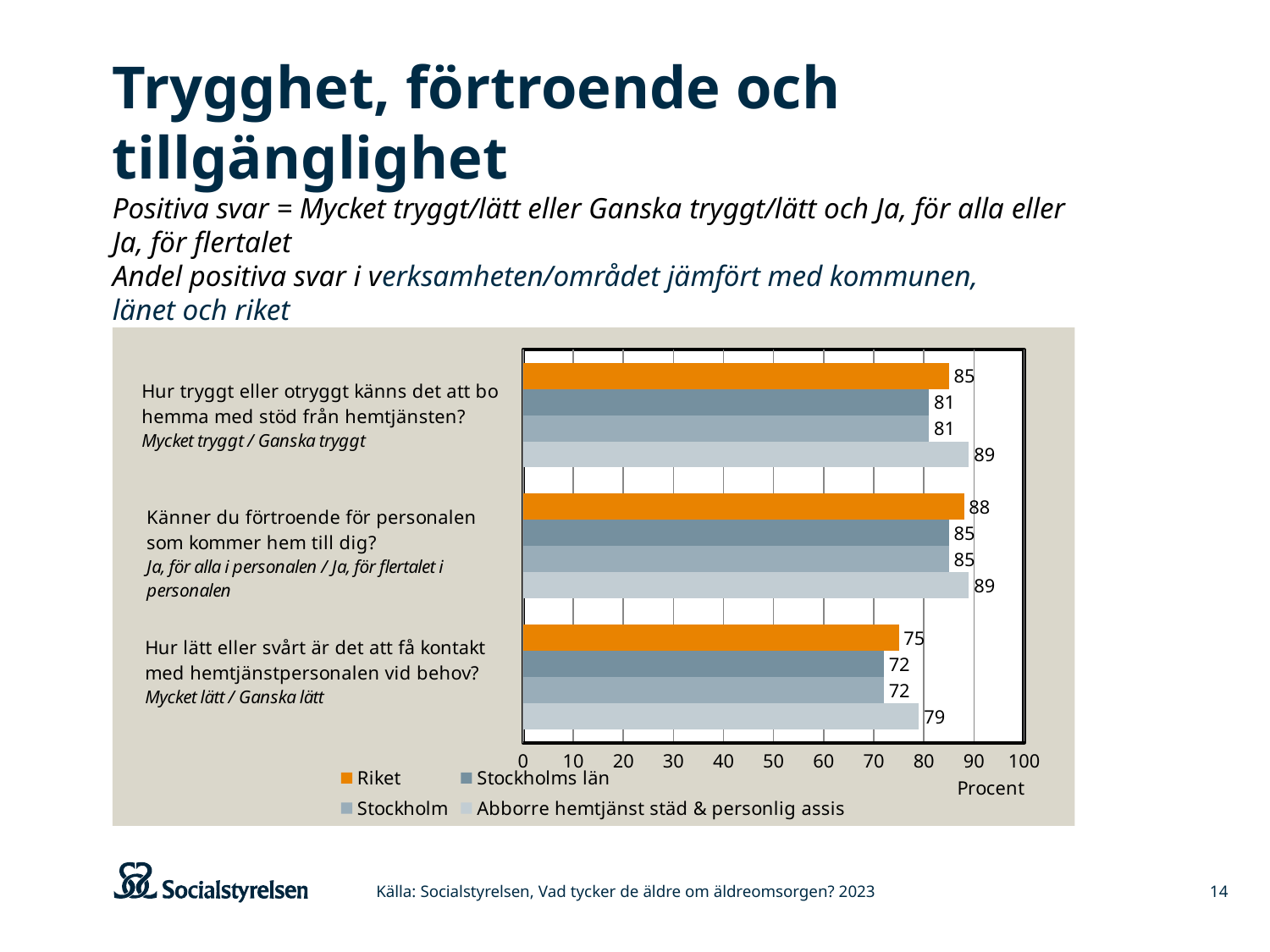
What is the value for Stockholms län on the question 'Hur lätt eller svårt är det att få kontakt med hemtjänstpersonalen vid behov?' 72 What type of chart is shown on the slide? bar chart What is the value for Riket on the question 'Hur tryggt eller otryggt känns det att bo hemma med stöd från hemtjänsten?' 85 Which question has the lowest value for Riket? Hur lätt eller svårt är det att få kontakt med hemtjänstpersonalen vid behov? Which series has the highest value on the question 'Hur lätt eller svårt är det att få kontakt med hemtjänstpersonalen vid behov?' Abborre hemtjänst städ & personlig assis What is the label of the x axis? Procent Is the value for Stockholm on the question 'Hur lätt eller svårt är det att få kontakt med hemtjänstpersonalen vid behov?' greater or less than 80? less How many question categories are plotted on the chart? 3 Which is larger on the question 'Känner du förtroende för personalen som kommer hem till dig?': Riket or Stockholm? Riket What is the value for Abborre hemtjänst städ & personlig assis on the question 'Känner du förtroende för personalen som kommer hem till dig?' 89 What is the difference between Abborre hemtjänst städ & personlig assis and Riket on the question 'Hur tryggt eller otryggt känns det att bo hemma med stöd från hemtjänsten?' 4 How many series does the legend list? 4